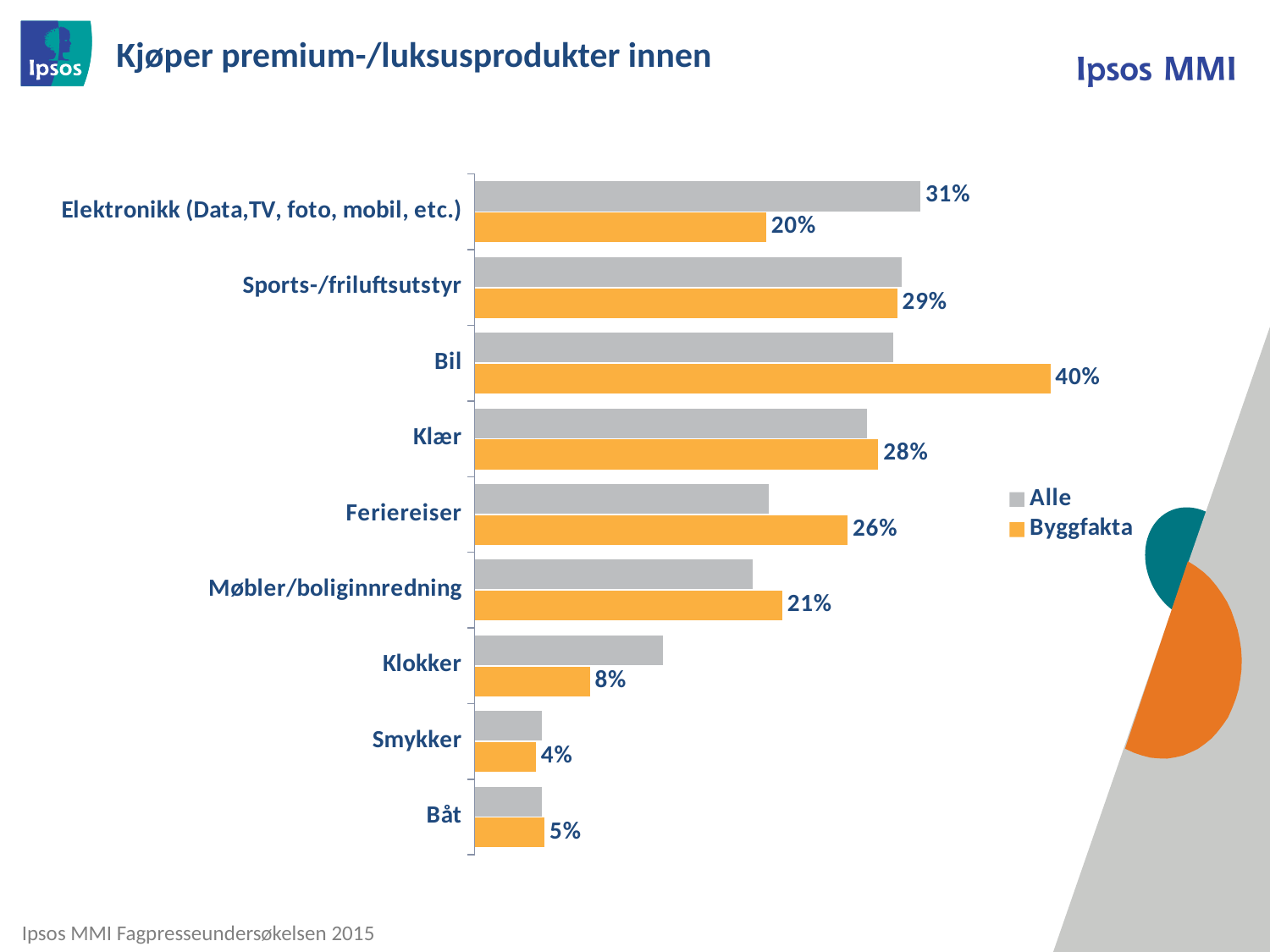
Which category has the highest Byggfakta value? Bil For Bil, which series has the larger value, Alle or Byggfakta? Byggfakta For Elektronikk (Data,TV, foto, mobil, etc.), what is the difference between the Alle value and the Byggfakta value? 11 percentage points What is the difference between the Byggfakta values for Bil and Sports-/friluftsutstyr? 11 percentage points What kind of chart is shown on the slide? Bar chart What is the Byggfakta value for Bil? 40% How many series does the legend list? 2 Which category has the lowest Byggfakta value? Smykker What is the Alle value for Elektronikk (Data,TV, foto, mobil, etc.)? 31% For Elektronikk (Data,TV, foto, mobil, etc.), which series has the larger value, Alle or Byggfakta? Alle How many categories are shown on the chart? 9 What is the Byggfakta value for Klokker? 8%